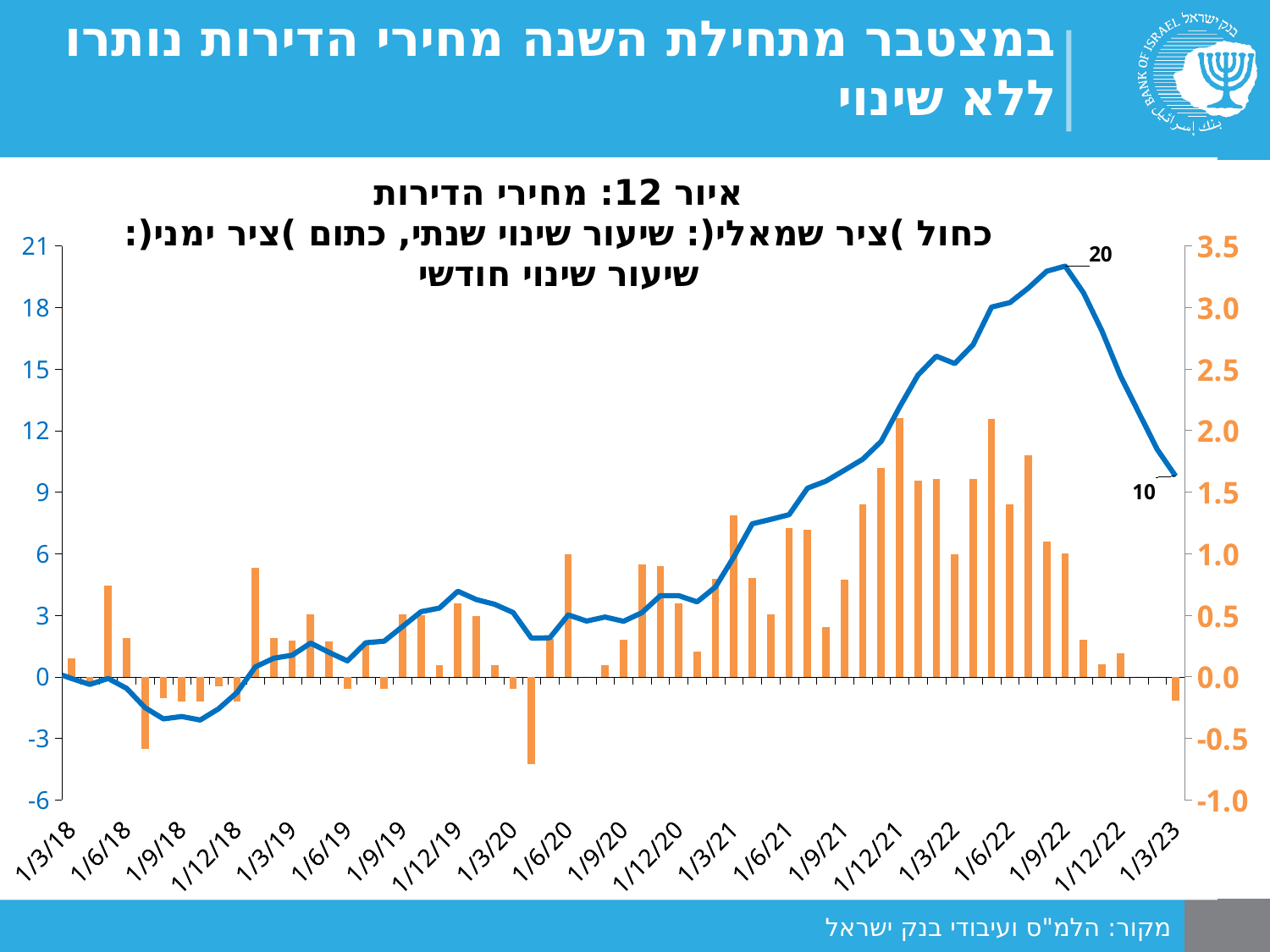
What is the labelled peak value of the blue line (annual change rate)? 20 Is the value of the blue line at 1/6/21 greater or less than 6? greater Which is larger: the blue line value at 1/3/18 or at 1/3/23? 1/3/23 What is the highest tick value on the right-hand axis? 3.5 Does the blue line rise or fall between 1/9/22 and 1/3/23? Fall Is the value of the blue line at 1/9/18 greater or less than 0? less What kind of chart is shown on the slide? A combined line and bar chart By how much did the blue line fall from its labelled peak of 20 to its labelled end value? 10 What colour are the bars showing the monthly change rate? Orange How many date labels are shown on the x axis? 21 Around which x-axis date does the blue line reach its highest point? 1/9/22 What is the labelled value of the blue line at the end of the series (1/3/23)? 10